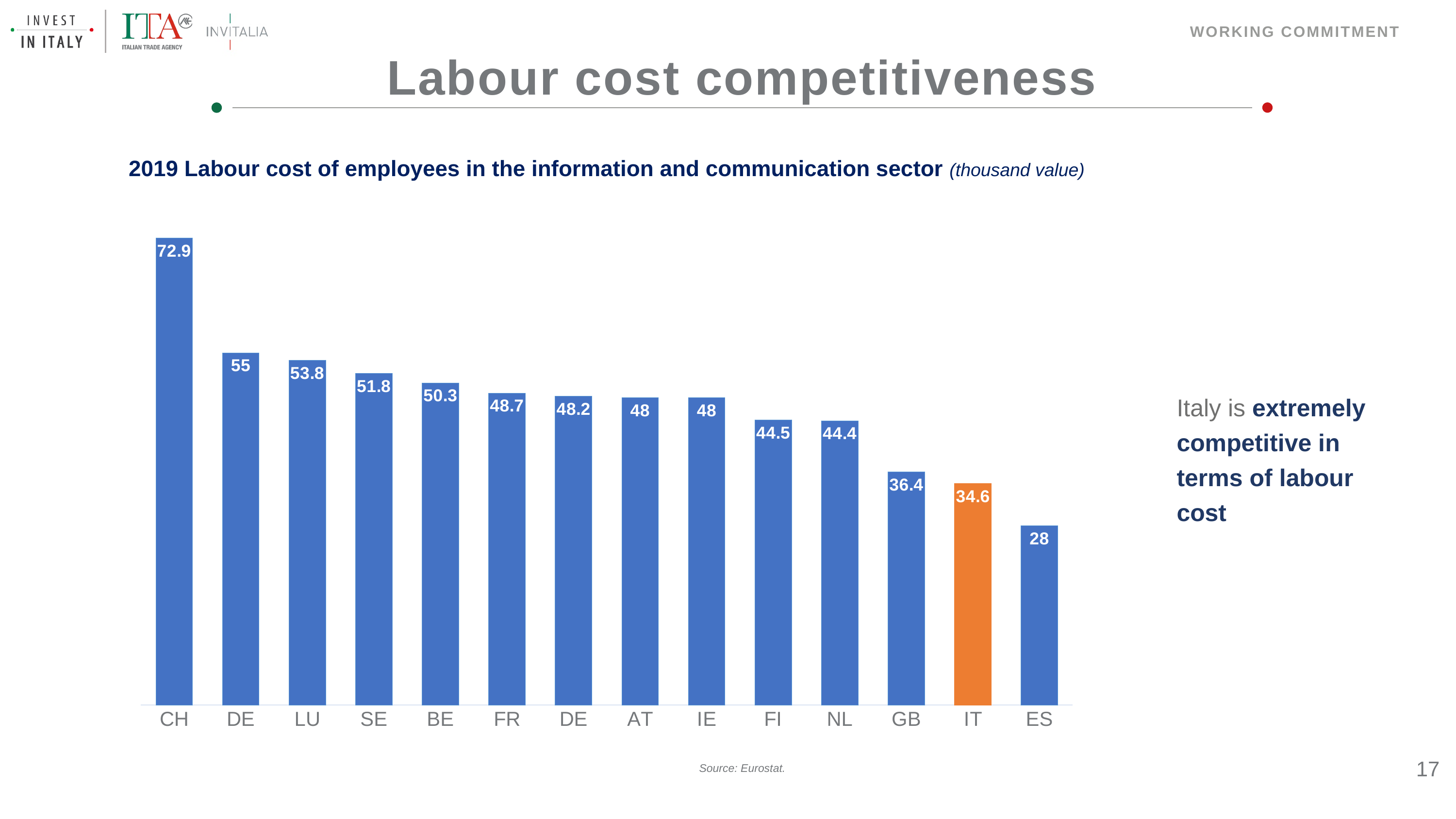
What is the labour cost value for GB? 36.4 Which has a higher labour cost value, FR or NL? FR What kind of chart is shown on the slide? Bar chart What is the labour cost value for CH? 72.9 How many countries are shown in the chart? 14 Which country has the highest labour cost in the chart? CH What is the difference between the labour cost values for CH and IT? 38.3 What is the labour cost value for LU? 53.8 What is the labour cost value for IT? 34.6 What is the difference between the labour cost values for GB and IT? 1.8 Which bar in the chart is coloured orange instead of blue? IT Which country has the lowest labour cost in the chart? ES